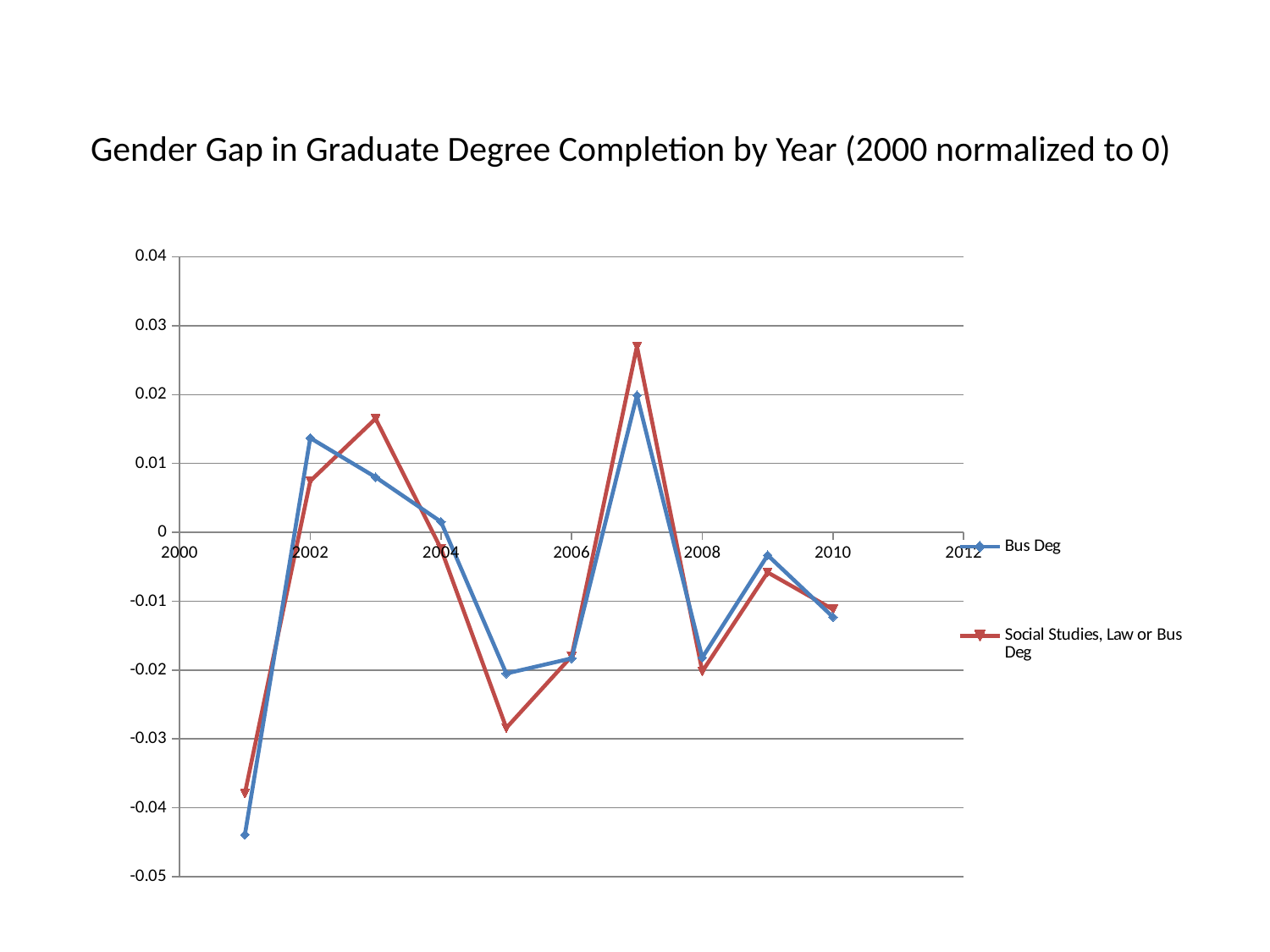
Is the value for Social Studies, Law or Bus Deg in 2005 greater or less than -0.02? less In 2002, which series has the higher value, Bus Deg or Social Studies, Law or Bus Deg? Bus Deg In which year does the Social Studies, Law or Bus Deg series reach its highest value? 2007 What is the title of the chart? Gender Gap in Graduate Degree Completion by Year (2000 normalized to 0) How many series does the legend list? 2 In which year does the Bus Deg series reach its highest value? 2007 Is the value for Bus Deg in 2001 greater or less than -0.04? less In which year does the Social Studies, Law or Bus Deg series reach its lowest value? 2001 What kind of chart is shown on the slide? line chart In 2003, which series has the higher value, Bus Deg or Social Studies, Law or Bus Deg? Social Studies, Law or Bus Deg In which year does the Bus Deg series reach its lowest value? 2001 Is the value for Social Studies, Law or Bus Deg in 2007 greater or less than 0.02? greater